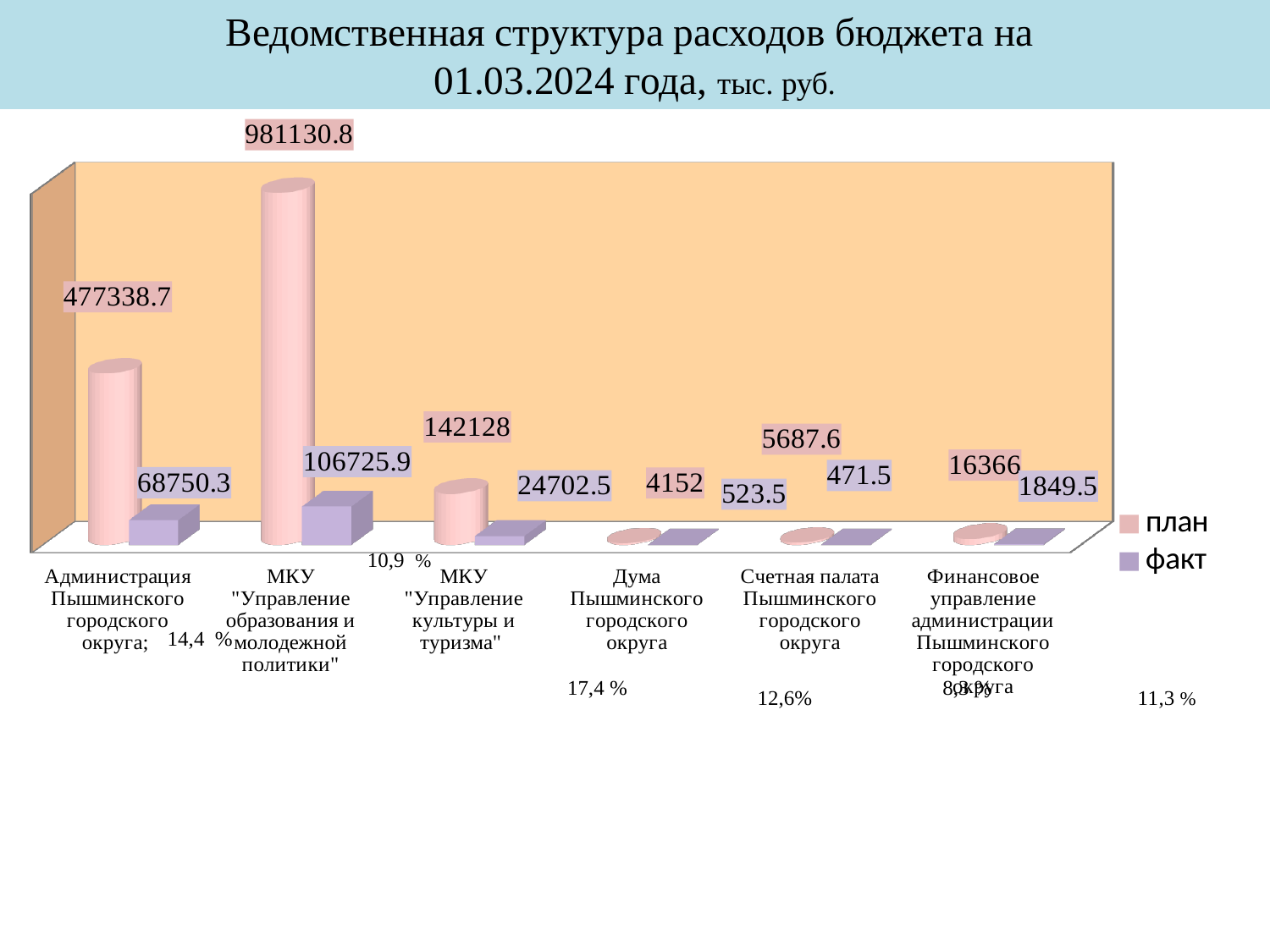
What is the факт value for Администрация Пышминского городского округа? 68750.3 What is the difference between the план and факт values for МКУ "Управление культуры и туризма"? 117425.5 Which is larger: the план value for Дума Пышминского городского округа or the план value for Счетная палата Пышминского городского округа? Счетная палата Пышминского городского округа Which category has the highest план value? МКУ "Управление образования и молодежной политики" What are the two series named in the legend? план and факт How many categories are shown on the x axis of the chart? 6 What is the план value for МКУ "Управление образования и молодежной политики"? 981130.8 What kind of chart is shown on the slide? bar chart What is the факт value for Счетная палата Пышминского городского округа? 471.5 How many series does the legend list? 2 What is the план value for Финансовое управление администрации Пышминского городского округа? 16366 Which category has the lowest факт value? Счетная палата Пышминского городского округа